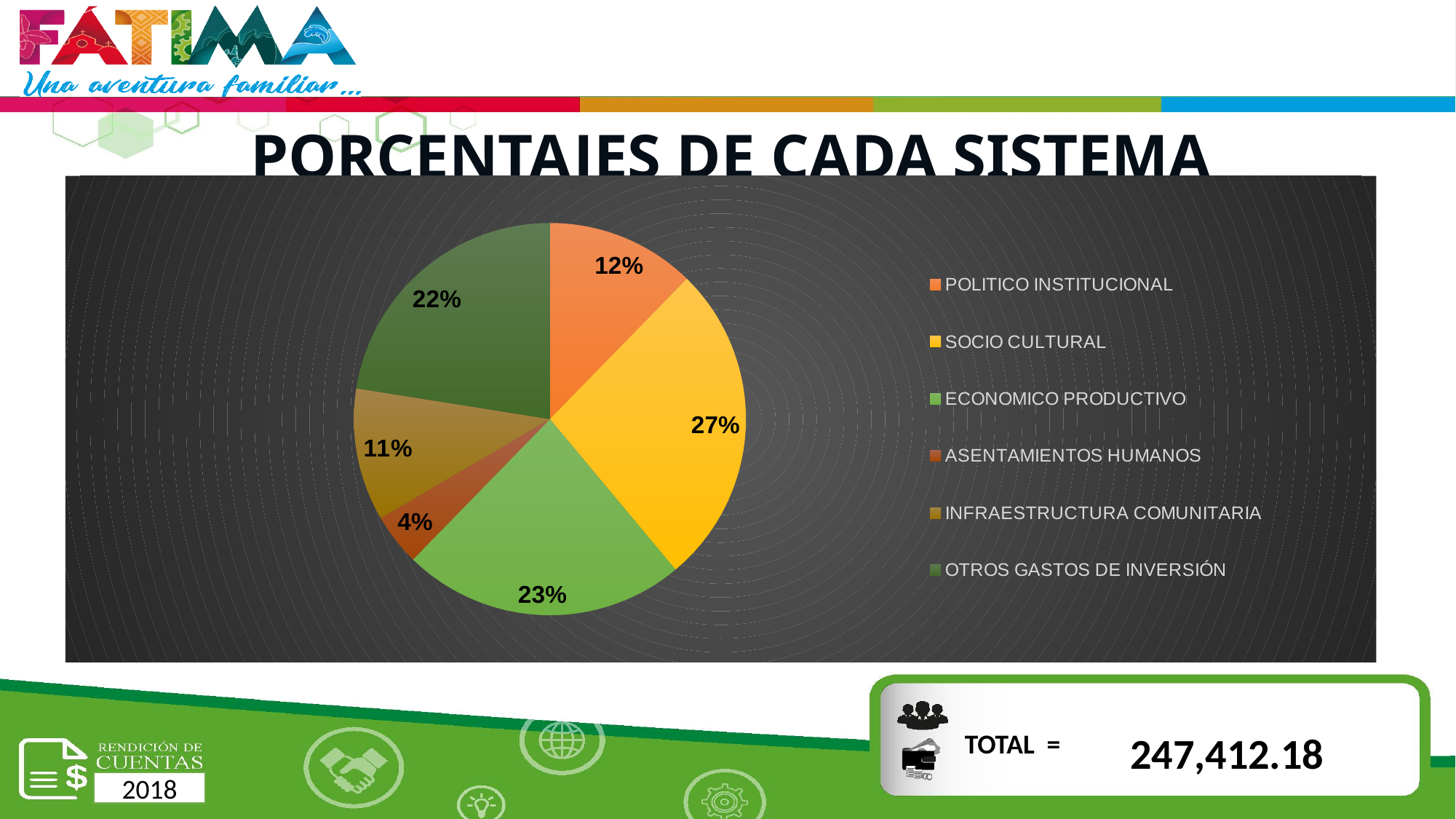
What kind of chart is shown on the slide? pie chart What percentage of the pie does OTROS GASTOS DE INVERSIÓN represent? 22% What percentage of the pie does ECONOMICO PRODUCTIVO represent? 23% How many slices does the pie chart have? 6 What percentage of the pie does ASENTAMIENTOS HUMANOS represent? 4% What is the difference in percentage points between SOCIO CULTURAL and POLITICO INSTITUCIONAL? 15 What total value is shown in the box below the chart? 247,412.18 Which category has the smallest share of the pie? ASENTAMIENTOS HUMANOS What percentage of the pie does SOCIO CULTURAL represent? 27% Which category has the largest share of the pie? SOCIO CULTURAL Which is larger, the share for ECONOMICO PRODUCTIVO or the share for OTROS GASTOS DE INVERSIÓN? ECONOMICO PRODUCTIVO What percentage of the pie does INFRAESTRUCTURA COMUNITARIA represent? 11%